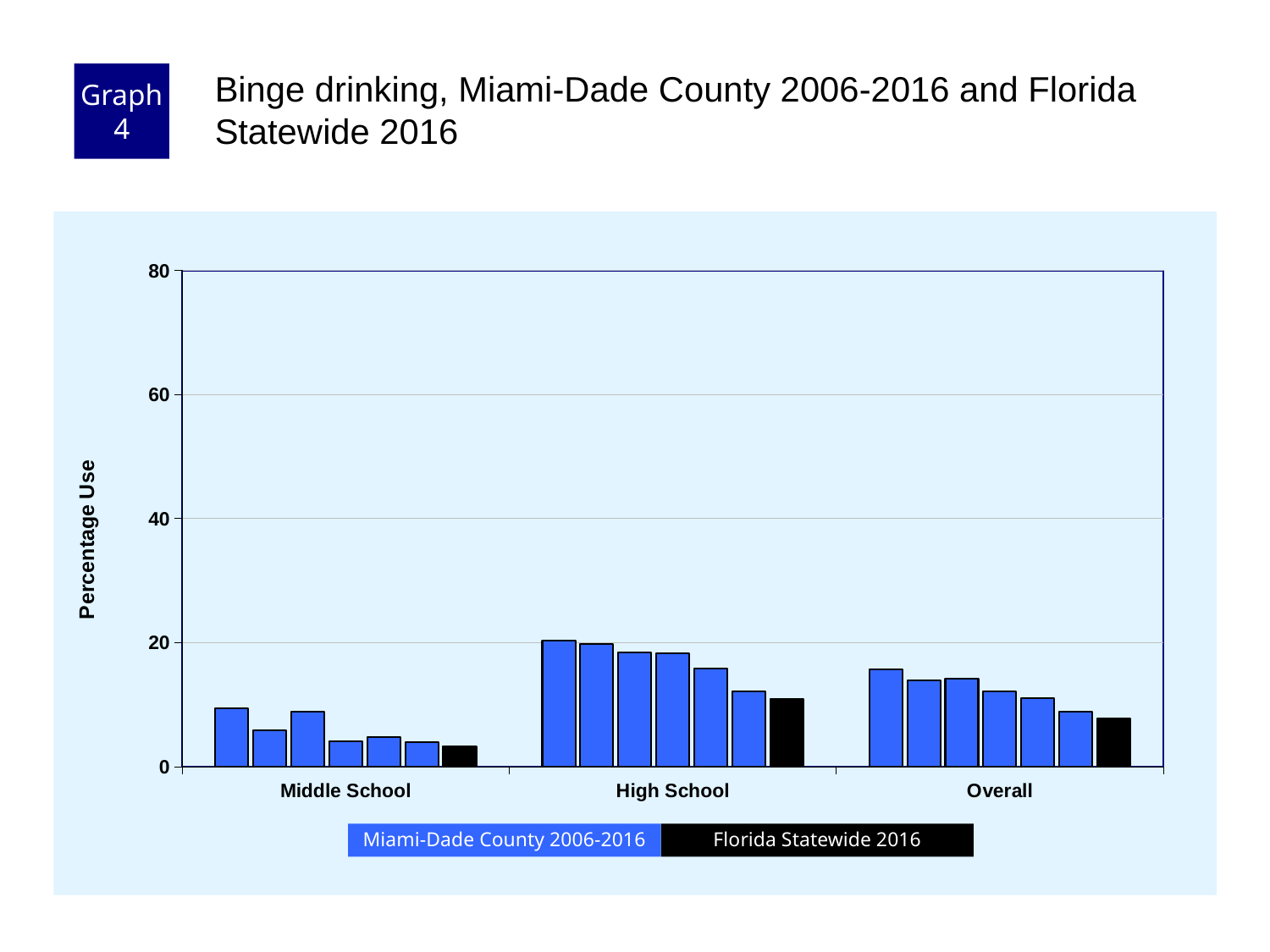
What kind of chart is shown on the slide? bar chart What colour are the Florida Statewide 2016 bars? black Are all the Overall bars greater or less than 20? less Which category has the lowest bars? Middle School How many categories are shown along the x axis? 3 Is the Florida Statewide 2016 value for Middle School greater or less than 20? less Which category has the highest bars? High School What is the label on the y axis? Percentage Use How many series does the legend list? 2 Is the Florida Statewide 2016 value for High School greater or less than 20? less Which is larger, the Florida Statewide 2016 bar for High School or the Florida Statewide 2016 bar for Middle School? High School Do the Miami-Dade County bars for High School rise or fall from left to right? fall